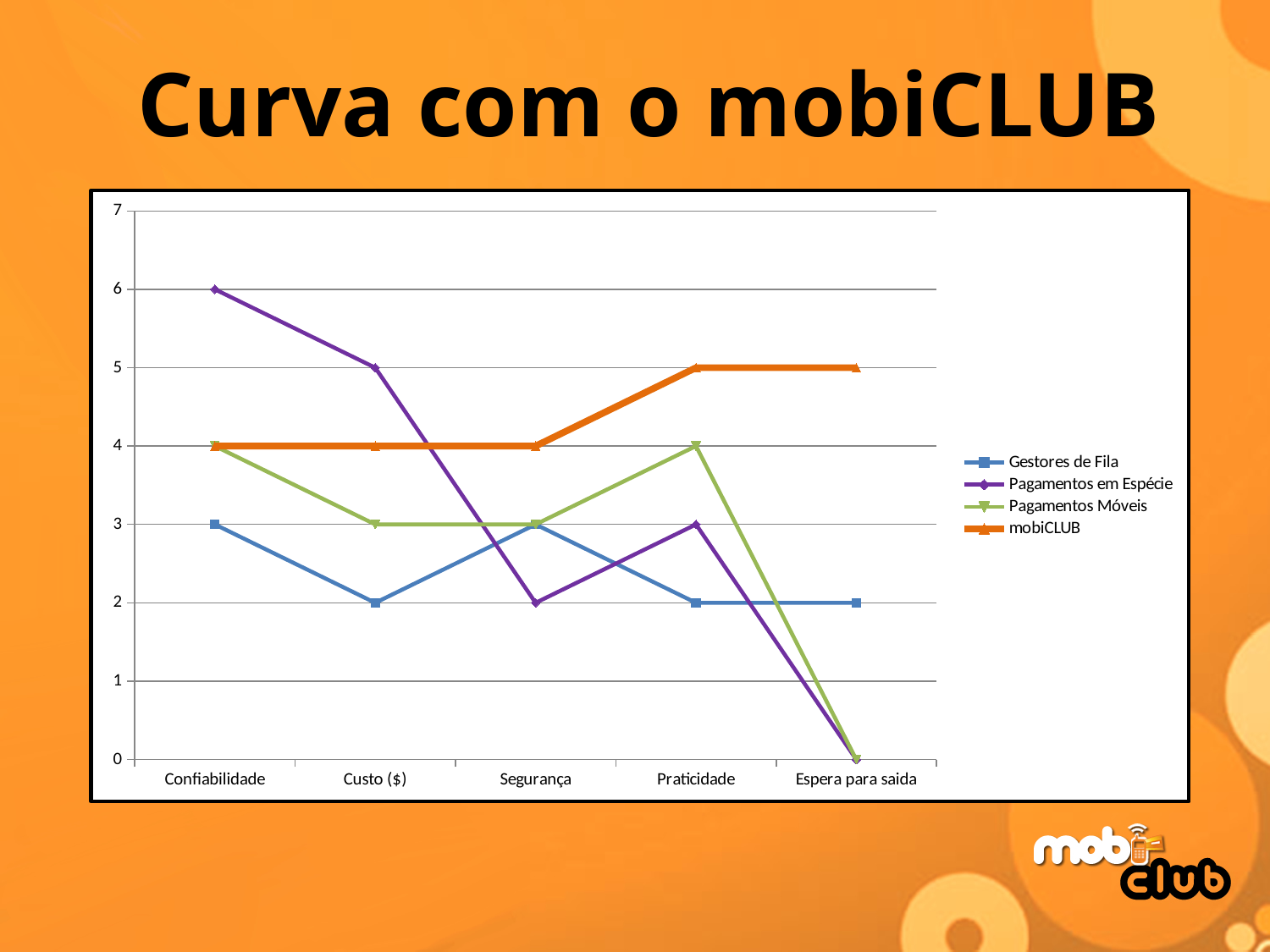
What is the value for mobiCLUB at Praticidade? 5 How many series does the legend list? 4 What is the value for Gestores de Fila at Custo ($)? 2 What is the value for Pagamentos Móveis at Espera para saida? 0 Does the mobiCLUB series rise or fall from Segurança to Praticidade? rise Which series has the highest value at Confiabilidade? Pagamentos em Espécie What is the difference between mobiCLUB and Gestores de Fila at Espera para saida? 3 Which series has the lowest value at Segurança? Pagamentos em Espécie What kind of chart is shown on the slide? line chart How many categories are shown on the x axis? 5 What is the value for Pagamentos em Espécie at Confiabilidade? 6 At Praticidade, which is larger: Pagamentos Móveis or Pagamentos em Espécie? Pagamentos Móveis